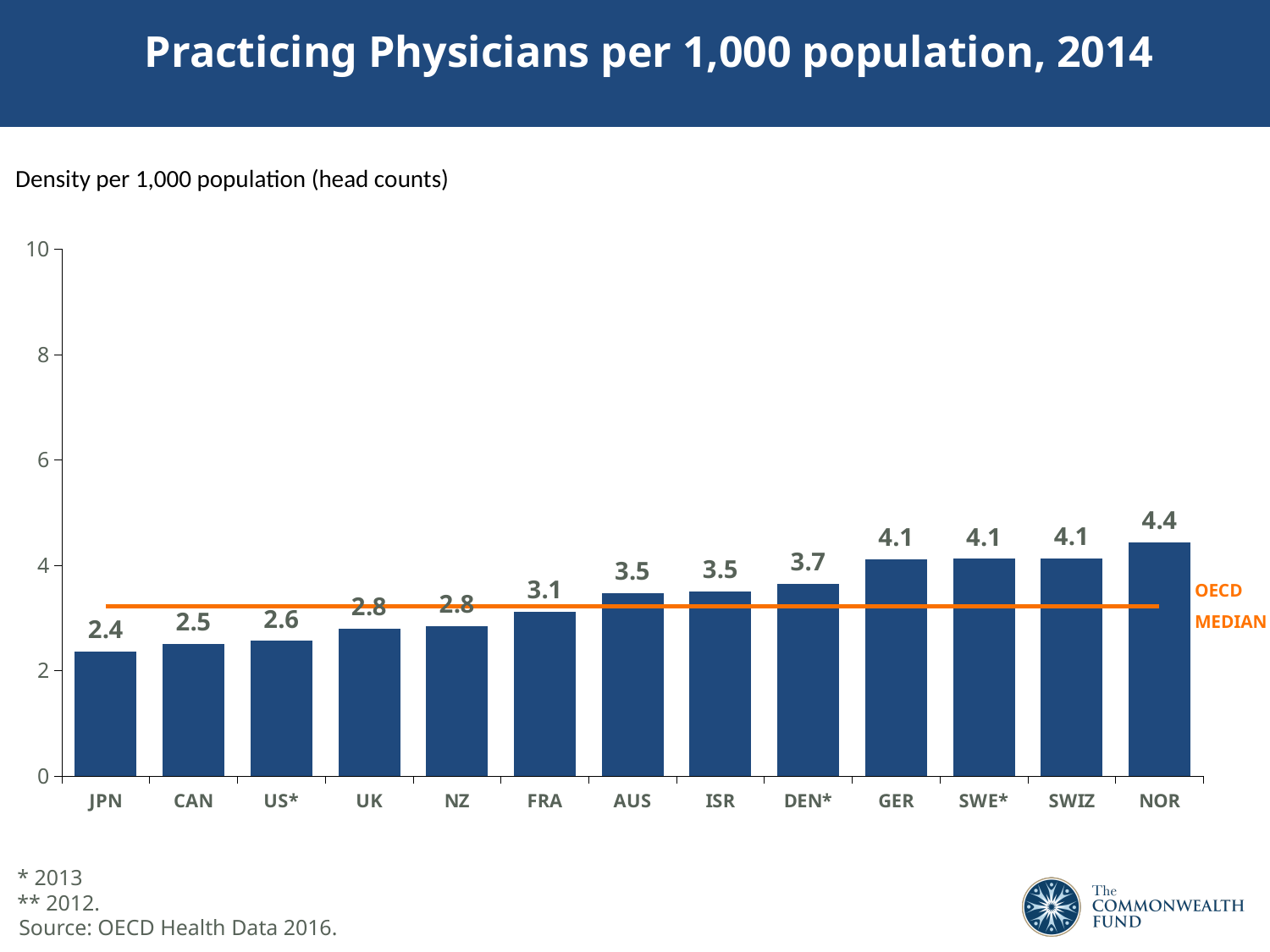
Which country has the lowest number of practicing physicians per 1,000 population? JPN What kind of chart is shown on the slide? Bar chart What is the value for JPN? 2.4 What is the difference between the values for NOR and JPN? 2.0 What is the value for DEN*? 3.7 What does the orange horizontal line on the chart represent? OECD median What is the value for FRA? 3.1 Which country has the highest number of practicing physicians per 1,000 population? NOR What is the difference between the values for GER and US*? 1.5 Which is larger, the value for AUS or the value for CAN? AUS Is the value for NOR greater or less than 4? greater How many countries are shown on the chart? 13